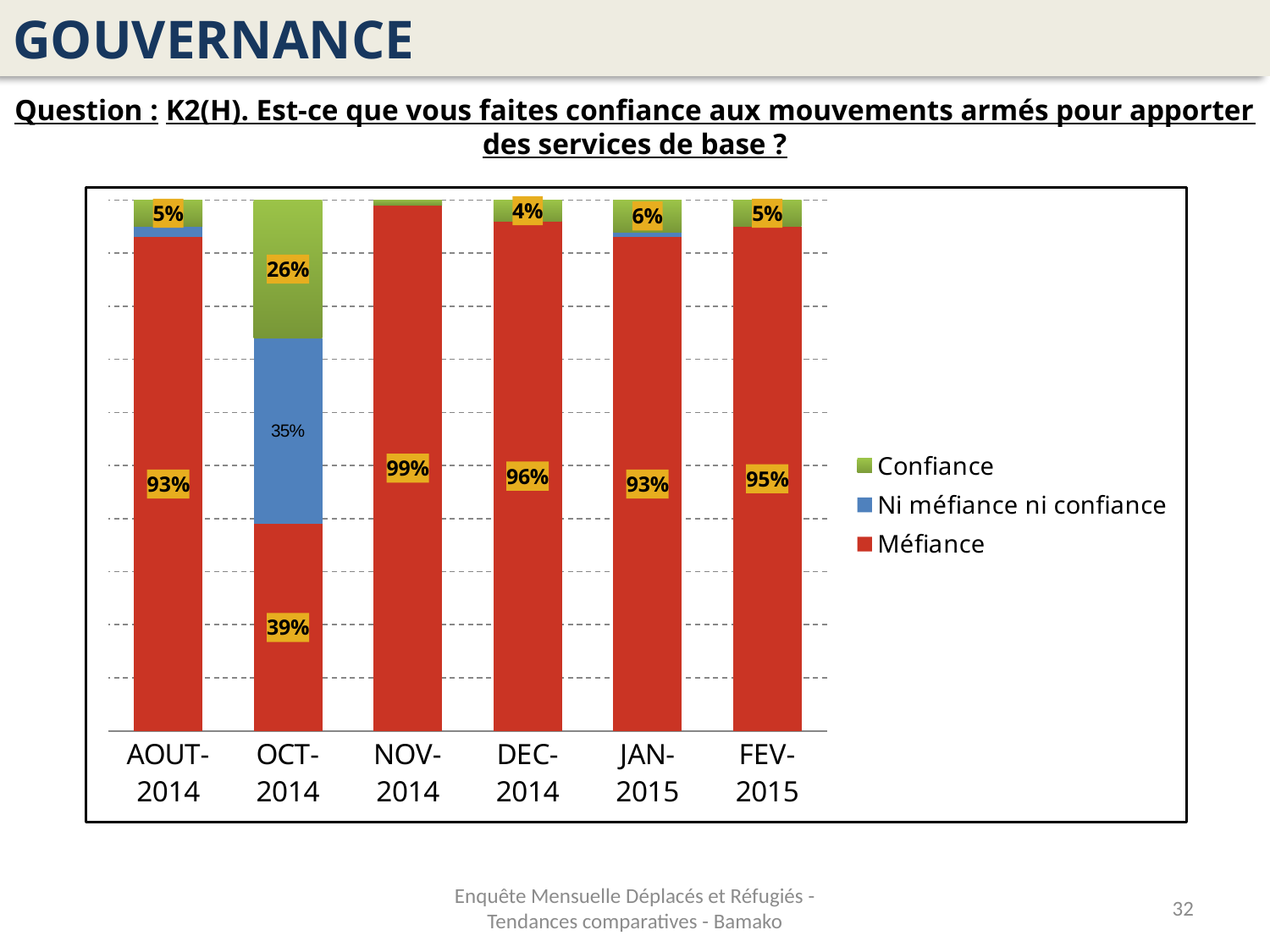
What is the difference between the Méfiance values for NOV-2014 and OCT-2014? 60% What type of chart is shown on the slide? stacked bar chart What is the 'Ni méfiance ni confiance' value for OCT-2014? 35% Which is larger, the Méfiance value for DEC-2014 or for FEV-2015? DEC-2014 What is the Confiance value for JAN-2015? 6% What is the Méfiance value for NOV-2014? 99% Which month has the highest Méfiance value? NOV-2014 How many series does the legend list? 3 How many months are shown on the x axis? 6 Which month has the lowest Méfiance value? OCT-2014 What is the Confiance value for OCT-2014? 26% What is the Méfiance value for OCT-2014? 39%